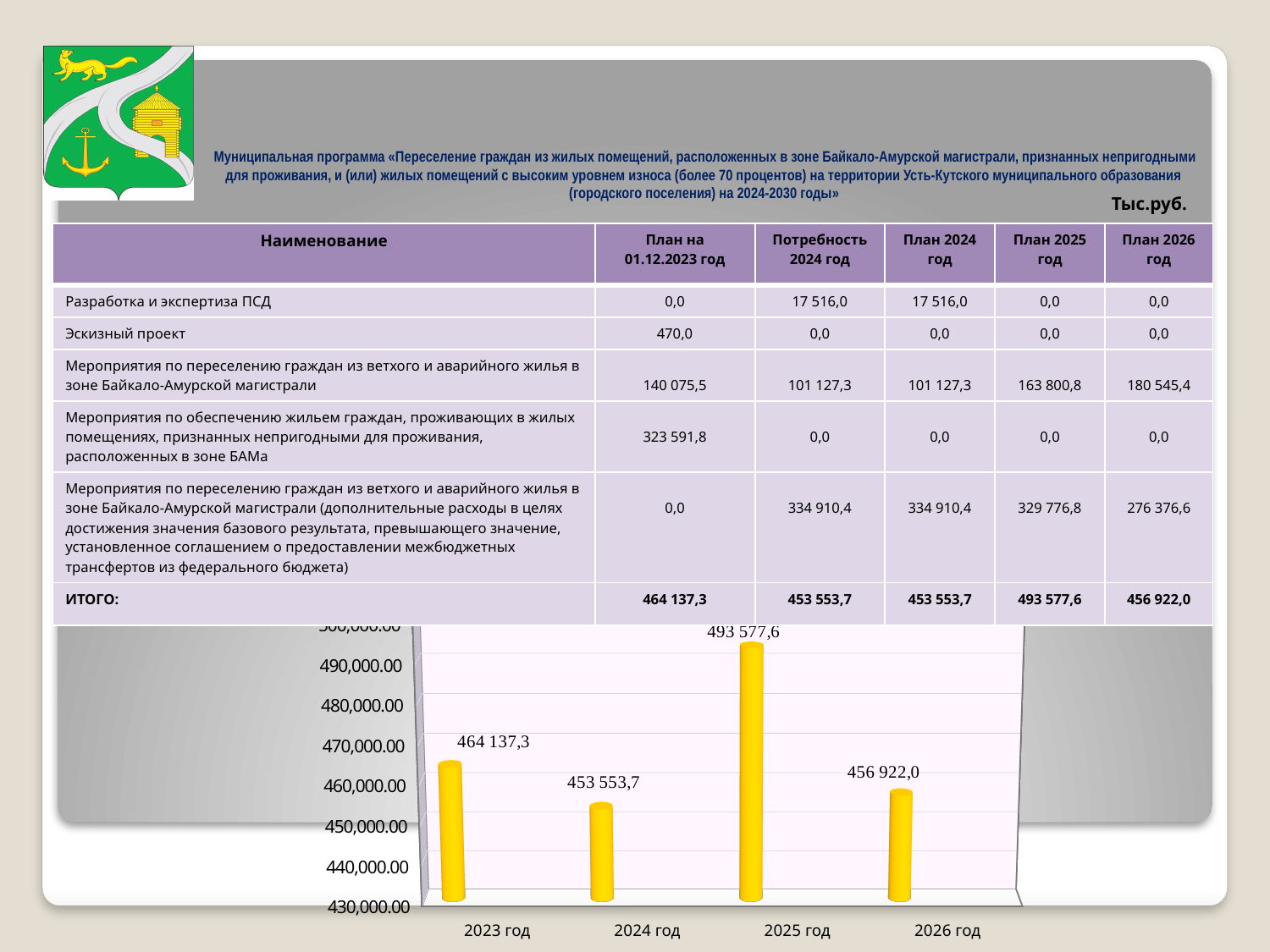
What is the value shown for 2025 год in the chart? 493 577,6 What is the value shown for 2024 год in the chart? 453 553,7 What is the value shown for 2026 год in the chart? 456 922,0 Which is larger in the chart, the value for 2023 год or the value for 2026 год? 2023 год What colour are the bars in the chart? yellow Which year has the lowest value in the chart? 2024 год What kind of chart is shown on the slide? bar chart What is the difference between the values for 2025 год and 2024 год in the chart? 40 023,9 How many years are plotted in the chart? 4 What is the value shown for 2023 год in the chart? 464 137,3 Is the value for 2025 год in the chart greater or less than 480,000.00? greater Which year has the highest value in the chart? 2025 год